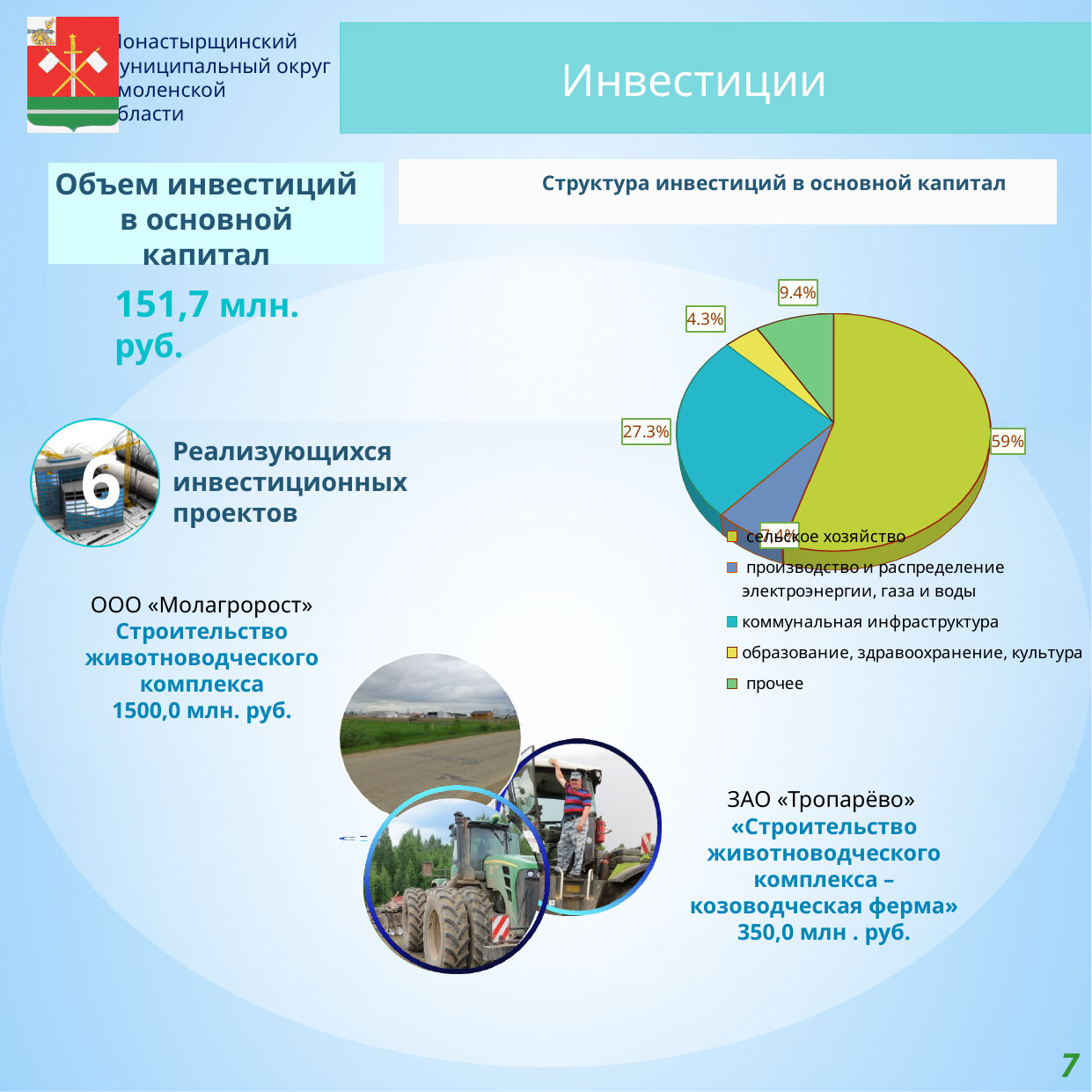
How many categories does the legend of the pie chart list? 5 What is the difference between the shares for прочее and образование, здравоохранение, культура? 5.1% What is the title of the chart? Структура инвестиций в основной капитал What share of the pie does сельское хозяйство have? 59% What kind of chart is shown on the slide? pie chart Which is larger: the share for сельское хозяйство or for коммунальная инфраструктура? сельское хозяйство What is the difference between the shares for сельское хозяйство and коммунальная инфраструктура? 31.7% Which category has the largest share of the pie? сельское хозяйство Which category has the smallest share of the pie? образование, здравоохранение, культура What share of the pie does образование, здравоохранение, культура have? 4.3% What share of the pie does прочее have? 9.4% What share of the pie does коммунальная инфраструктура have? 27.3%